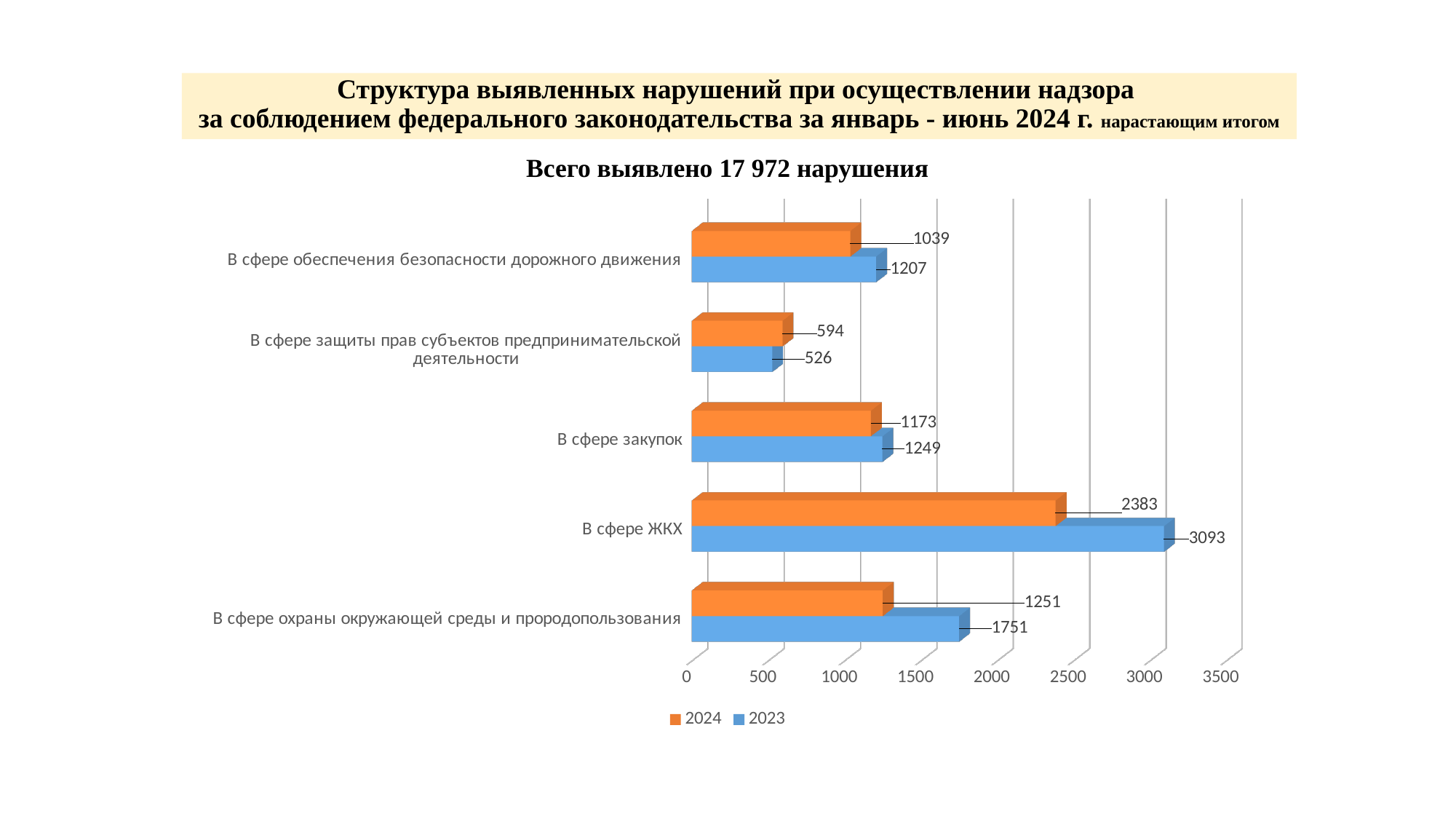
What is the 2023 value for "В сфере охраны окружающей среды и прородопользования"? 1751 Is the 2023 value for "В сфере обеспечения безопасности дорожного движения" greater or less than 1000? greater What is the difference between the 2023 and 2024 values for "В сфере ЖКХ"? 710 How many series does the legend list? 2 What type of chart is shown on the slide? Bar chart For "В сфере закупок", which series has the larger value, 2024 or 2023? 2023 What is the 2024 value for "В сфере ЖКХ"? 2383 Which category has the lowest 2024 value? В сфере защиты прав субъектов предпринимательской деятельности How many categories are shown on the chart? 5 Which colour represents the 2024 series in the legend? Orange What is the 2024 value for "В сфере защиты прав субъектов предпринимательской деятельности"? 594 Which category has the highest 2023 value? В сфере ЖКХ